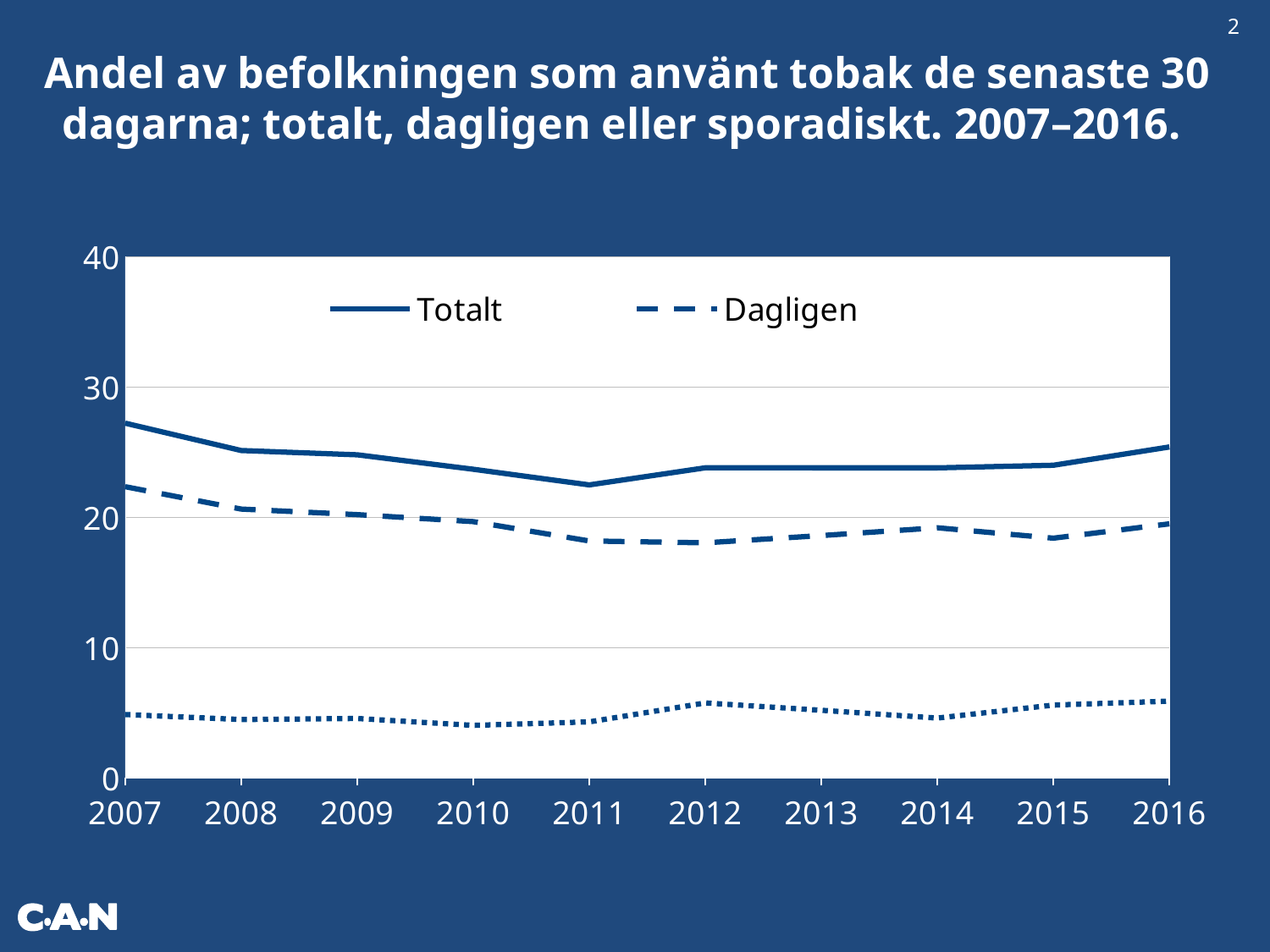
Is the value for Totalt in 2011 greater or less than 30? less In which year is the Totalt line at its highest? 2007 In which year is the Dagligen line at its highest? 2007 In which year is the Totalt line at its lowest? 2011 Is the value for Dagligen in 2007 greater or less than 20? greater Which series does the solid line represent according to the legend? Totalt Which is larger in 2016, the Totalt value or the Dagligen value? Totalt Is the value for Totalt in 2007 greater or less than 20? greater Does the Totalt line rise or fall from 2007 to 2011? fall What kind of chart is shown on the slide? line chart How many years are plotted along the x axis? 10 How many series does the legend list? 2